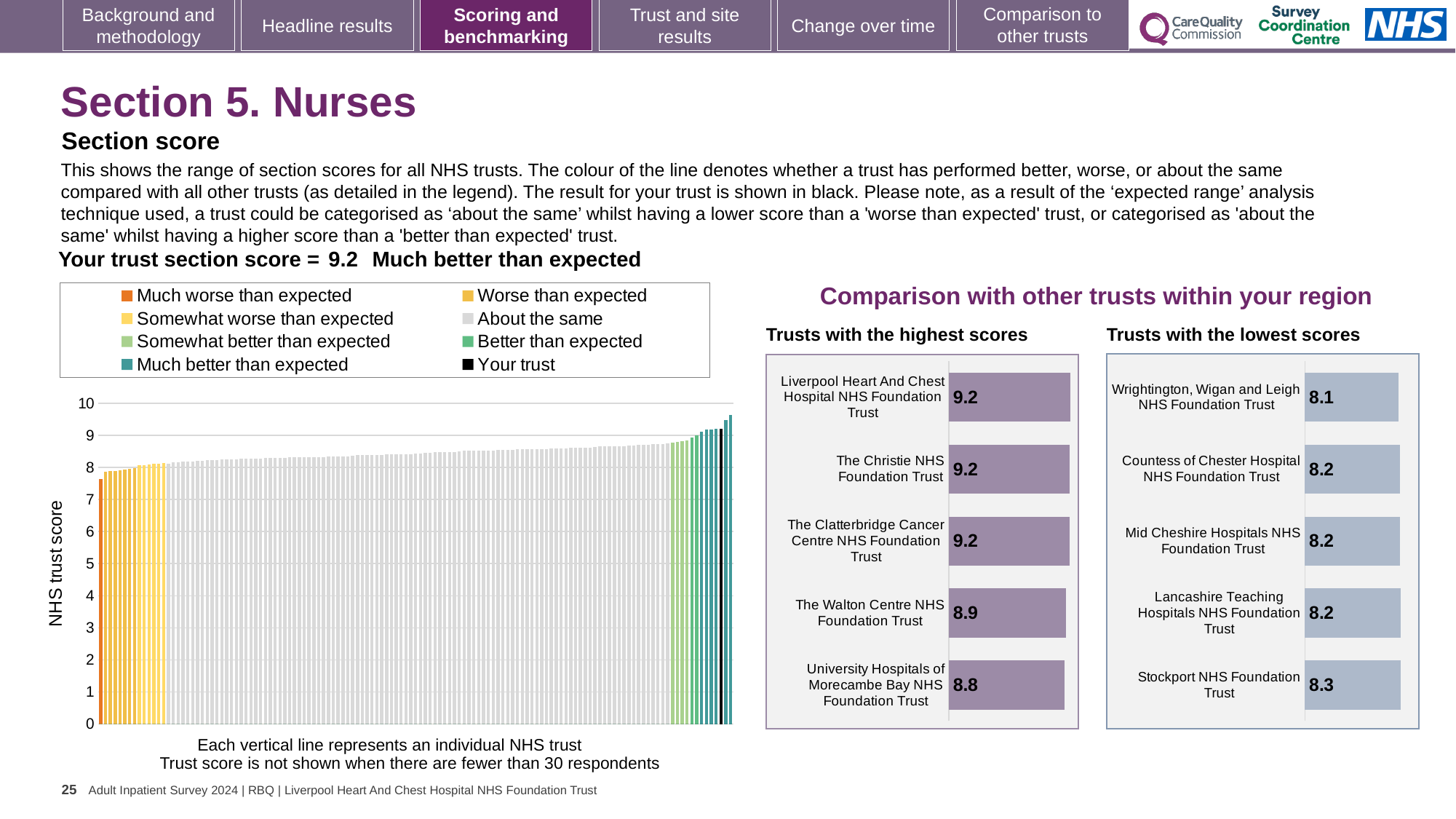
How many trusts are shown in the 'Trusts with the highest scores' chart? 5 In the large chart on the left, is the value of the black 'Your trust' bar greater or less than 9? greater How many entries does the legend of the large chart on the left list? 8 In the 'Trusts with the highest scores' chart, which trust has the lowest score? University Hospitals of Morecambe Bay NHS Foundation Trust In the 'Trusts with the lowest scores' chart, which trust has the highest score? Stockport NHS Foundation Trust What kind of chart is the large chart on the left showing NHS trust scores? Bar chart In the 'Trusts with the highest scores' chart, which has the larger score: The Walton Centre NHS Foundation Trust or University Hospitals of Morecambe Bay NHS Foundation Trust? The Walton Centre NHS Foundation Trust In the 'Trusts with the highest scores' chart, what is the score for The Walton Centre NHS Foundation Trust? 8.9 In the 'Trusts with the lowest scores' chart, what is the score for Wrightington, Wigan and Leigh NHS Foundation Trust? 8.1 In the 'Trusts with the lowest scores' chart, what is the difference between the scores of Stockport NHS Foundation Trust and Wrightington, Wigan and Leigh NHS Foundation Trust? 0.2 In the large chart on the left, is the value of the orange 'Much worse than expected' bar greater or less than 8? less What is the y-axis label of the large chart on the left? NHS trust score